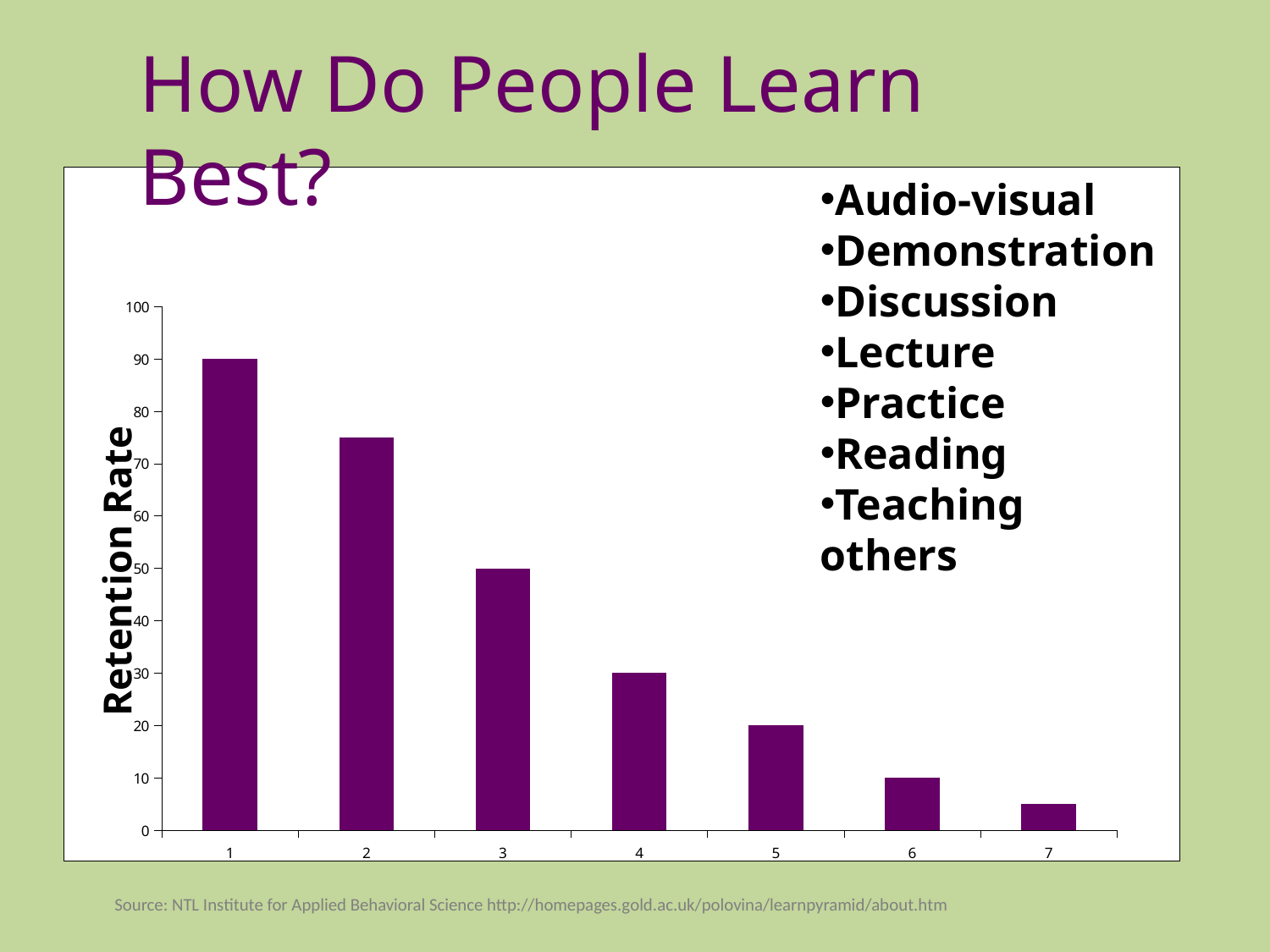
Do the values rise or fall as you move from category 1 to category 7? Fall Is the value for category 2 greater or less than 70? greater What is the retention rate for category 6? 10 Which category has the lowest retention rate? 7 How many bars (categories) are plotted in the chart? 7 Is the value for category 7 greater or less than 10? less What is the difference between the retention rates of category 1 and category 5? 70 What is the retention rate for category 1? 90 Which category has the highest retention rate? 1 What is the retention rate for category 4? 30 What type of chart is shown on the slide? Bar chart What is the retention rate for category 3? 50